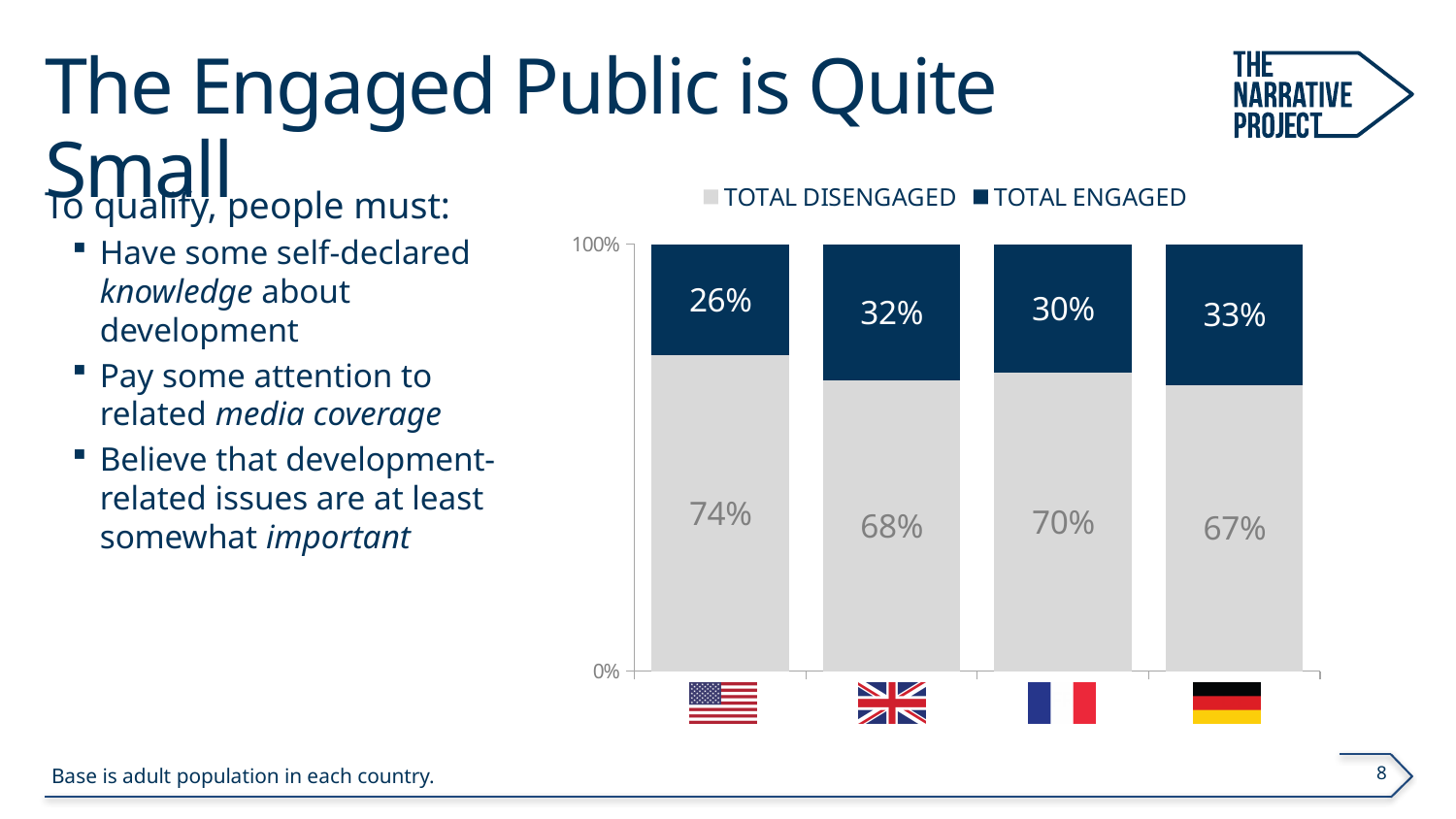
What is the difference between the TOTAL DISENGAGED values for the US and Germany bars? 7% What is the TOTAL ENGAGED value for the bar marked with the US flag? 26% What is the total of the stacked bar marked with the UK flag? 100% Which country's bar has the highest TOTAL ENGAGED value? Germany How many bars (countries) are shown in the chart? 4 What is the TOTAL ENGAGED value for the bar marked with the French flag? 30% What is the TOTAL DISENGAGED value for the bar marked with the German flag? 67% What is the TOTAL DISENGAGED value for the bar marked with the UK flag? 68% What kind of chart is shown on the slide? Stacked bar chart Which country's bar has the lowest TOTAL ENGAGED value? United States Which is larger: the TOTAL ENGAGED value for the UK bar or for the French bar? UK How many series does the legend list? 2